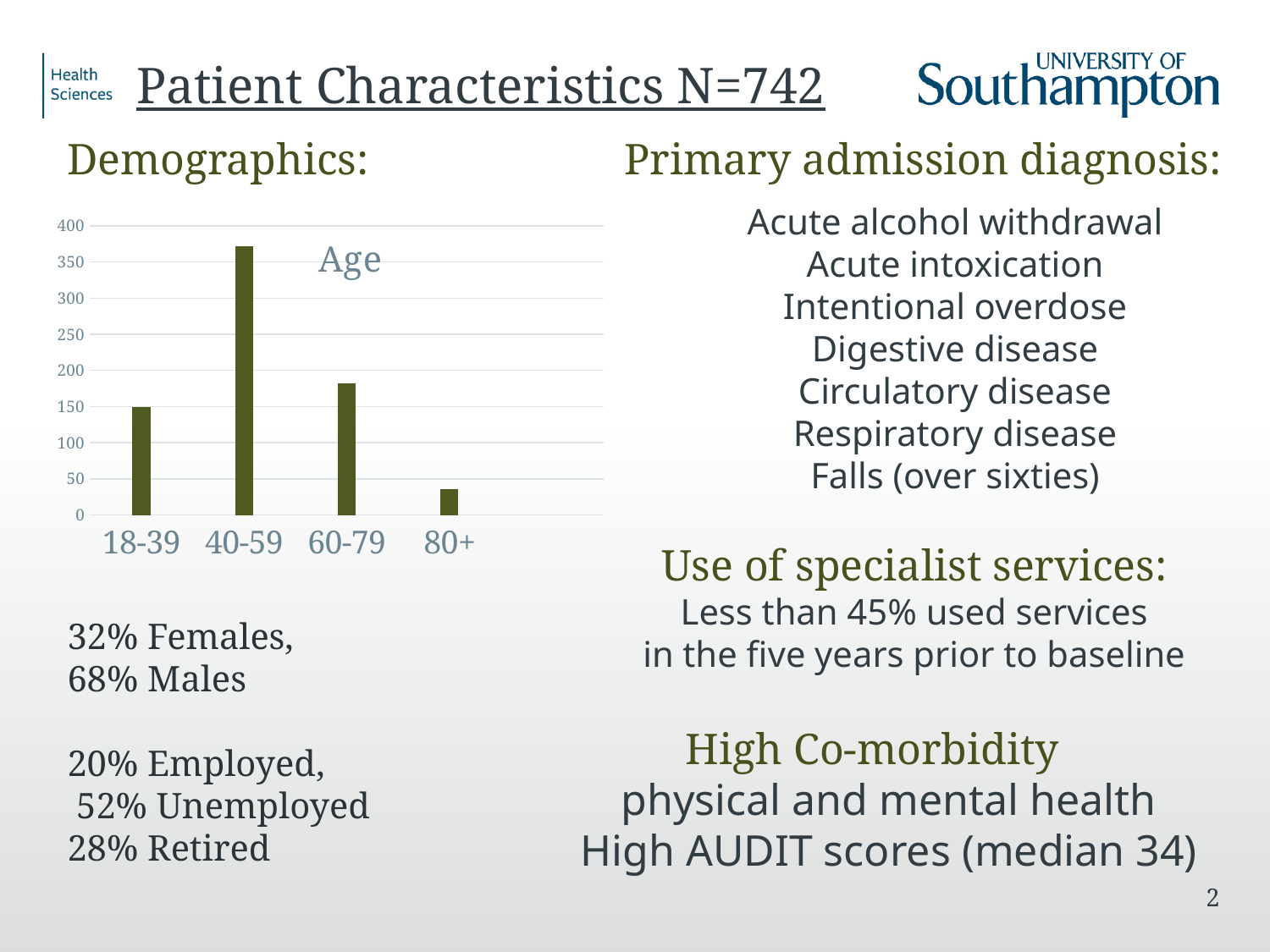
What is the title of the bar chart on the slide? Age Which age group has the lowest value in the Age chart? 80+ What kind of chart is the Age chart? bar chart In the Age chart, which is larger: the value for 40-59 or the value for 60-79? 40-59 Is the value for 40-59 in the Age chart greater or less than 350? greater Is the value for 18-39 in the Age chart greater or less than 100? greater How many age categories are shown on the x axis of the Age chart? 4 Which age group has the highest value in the Age chart? 40-59 Do the values in the Age chart rise or fall from 40-59 to 80+? fall Is the value for 60-79 in the Age chart greater or less than 200? less In the Age chart, which is larger: the value for 18-39 or the value for 60-79? 60-79